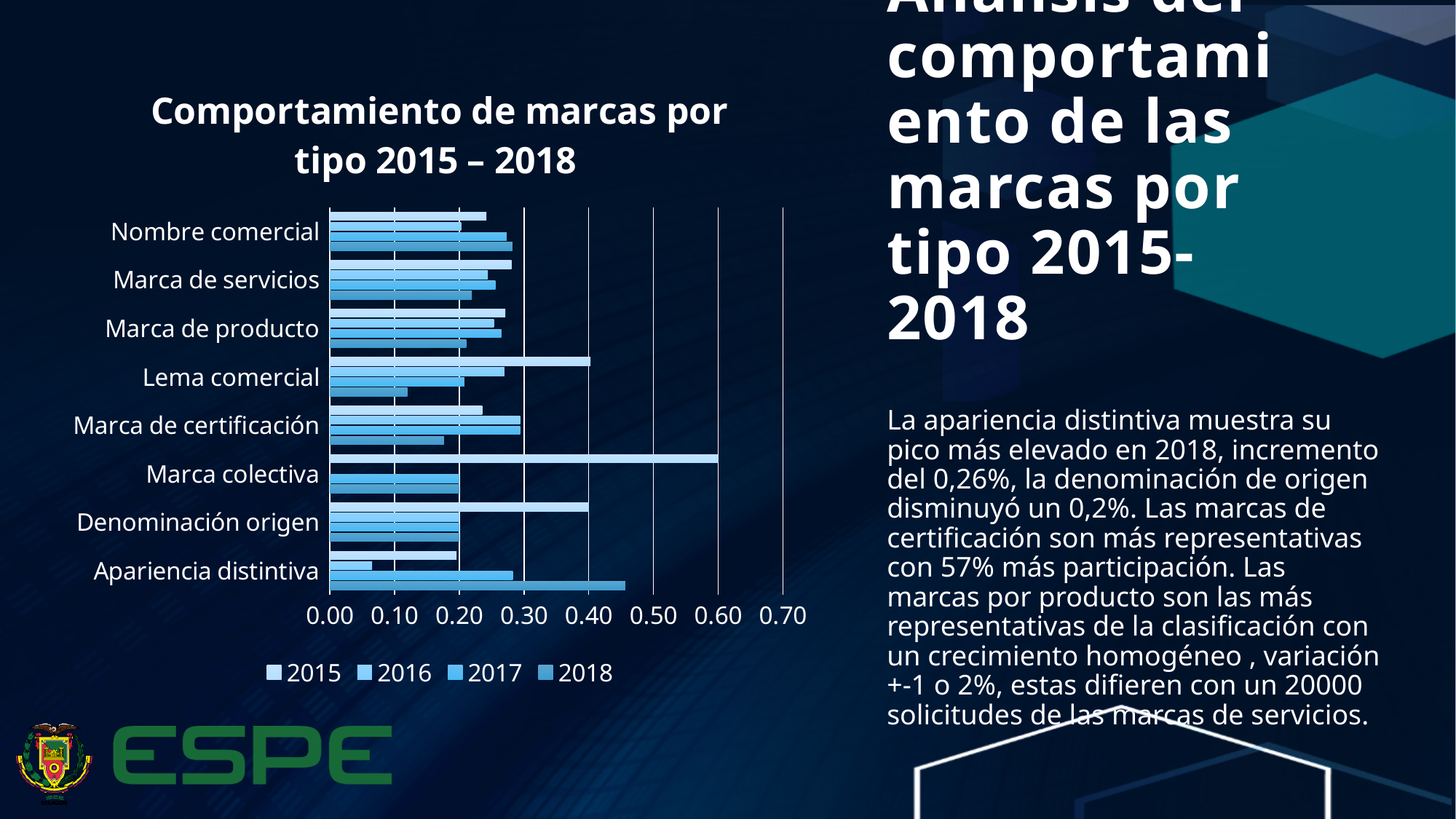
For Apariencia distintiva, which is larger: the 2016 value or the 2018 value? 2018 Is the 2018 value for Apariencia distintiva greater or less than 0.40? greater Is the 2018 value for Lema comercial greater or less than 0.20? less For Lema comercial, do the values rise or fall from 2015 to 2018? fall Which category has the highest value for the 2015 series? Marca colectiva Which years are listed in the chart's legend? 2015, 2016, 2017, 2018 What kind of chart is shown on the slide? Bar chart How many series does the chart's legend list? 4 Which category has the lowest value for the 2016 series? Marca colectiva What is the title of the chart? Comportamiento de marcas por tipo 2015 – 2018 Is the 2015 value for Marca colectiva greater or less than 0.50? greater How many categories are shown on the chart's vertical axis? 8